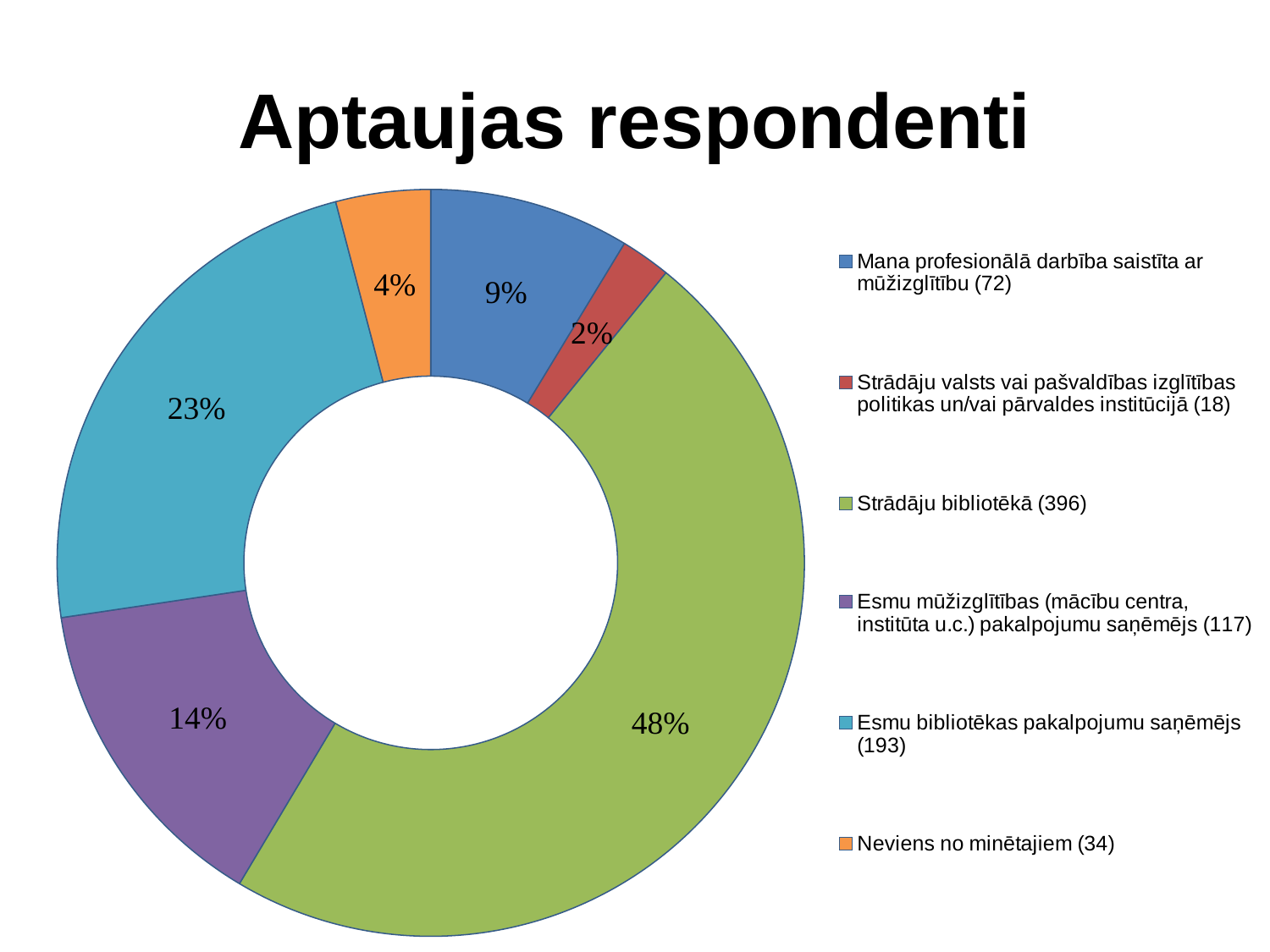
What percentage is shown for "Esmu bibliotēkas pakalpojumu saņēmējs"? 23% What share of the chart is labelled for "Strādāju bibliotēkā"? 48% What kind of chart is shown on the slide? Doughnut (pie) chart Which category has the largest share of the chart? Strādāju bibliotēkā Which has a larger share: "Mana profesionālā darbība saistīta ar mūžizglītību" or "Neviens no minētajiem"? Mana profesionālā darbība saistīta ar mūžizglītību What is the title of the chart? Aptaujas respondenti How many respondents does the legend give for "Strādāju bibliotēkā"? 396 What is the difference in percentage points between "Esmu bibliotēkas pakalpojumu saņēmējs" (23%) and "Esmu mūžizglītības (mācību centra, institūta u.c.) pakalpojumu saņēmējs" (14%)? 9 percentage points Which category has the smallest share of the chart? Strādāju valsts vai pašvaldības izglītības politikas un/vai pārvaldes institūcijā How many categories does the legend list? 6 What percentage is shown for "Neviens no minētajiem"? 4% What colour is the slice for "Esmu mūžizglītības (mācību centra, institūta u.c.) pakalpojumu saņēmējs"? Purple